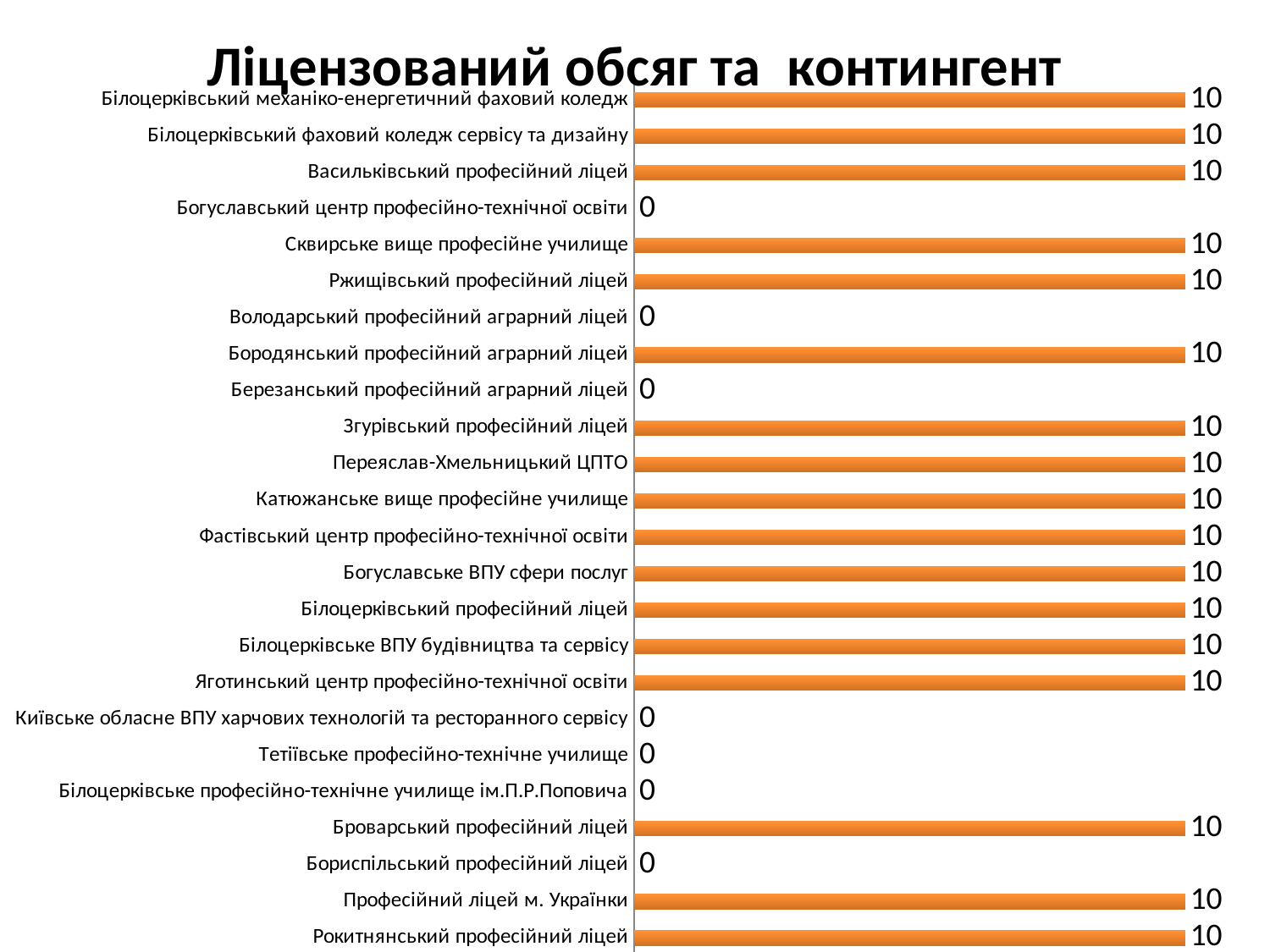
What is the value for Богуславський центр професійно-технічної освіти? 0 How many institutions have a value of 0 on the chart? 7 What is the value for Бориспільський професійний ліцей? 0 What is the title of the chart? Ліцензований обсяг та контингент What is the difference between the values for Сквирське вище професійне училище and Березанський професійний аграрний ліцей? 10 What is the value for Тетіївське професійно-технічне училище? 0 What colour are the bars on the chart? orange Which has the larger value: Броварський професійний ліцей or Володарський професійний аграрний ліцей? Броварський професійний ліцей What is the value for Рокитнянський професійний ліцей? 10 What is the value for Васильківський професійний ліцей? 10 How many institutions (categories) are listed on the chart? 24 What type of chart is shown on the slide? bar chart